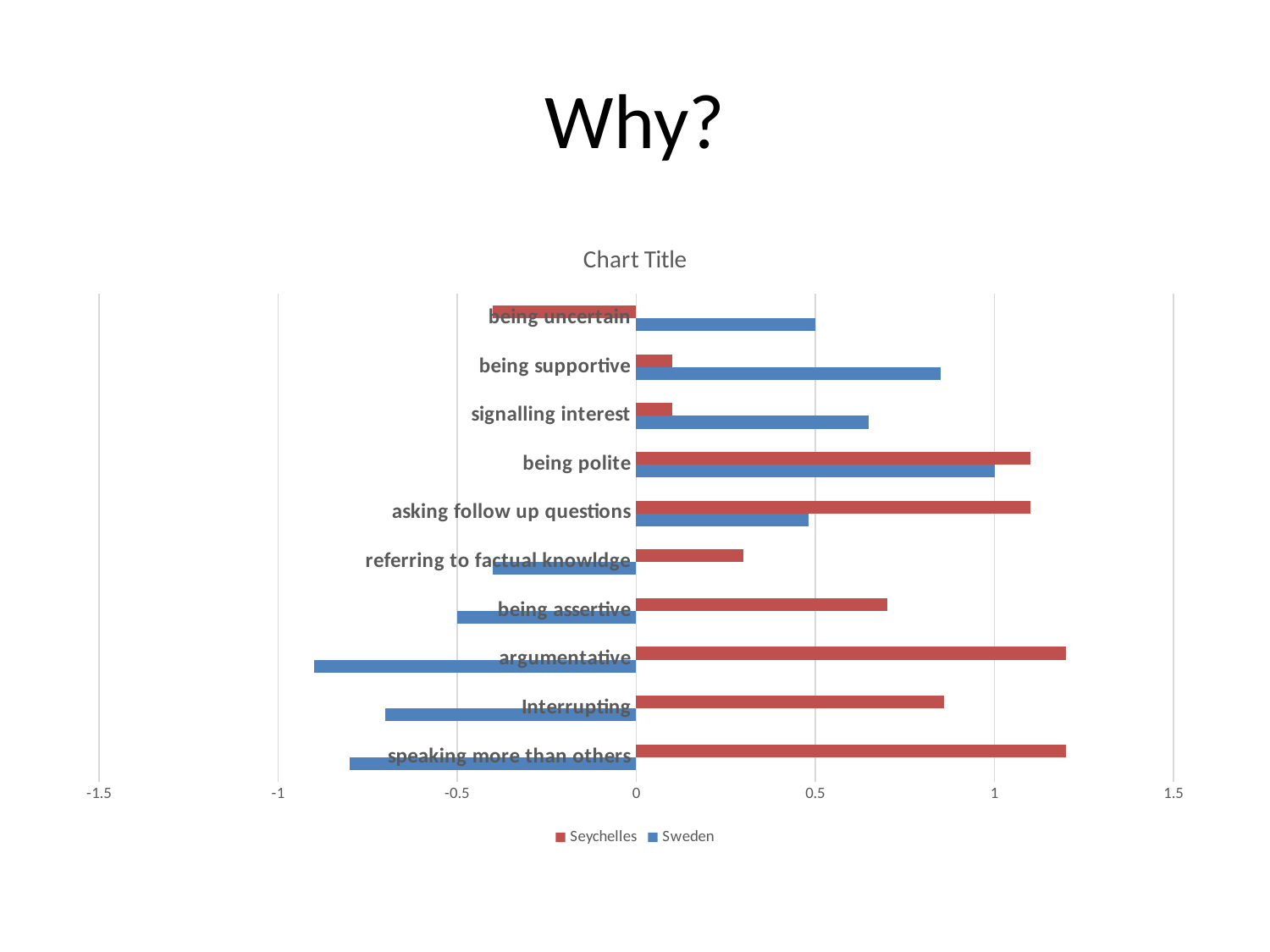
Is the value for Seychelles for argumentative greater or less than 1? greater For being supportive, which series has the larger value, Seychelles or Sweden? Sweden Which category has the highest value for Sweden? being polite Which series is shown in red? Seychelles Which category has the lowest value for Seychelles? being uncertain What kind of chart is shown on the slide? bar chart How many categories are plotted on the chart? 10 Is the value for Sweden for argumentative greater or less than -0.5? less Which category has the lowest value for Sweden? argumentative How many series does the legend list? 2 For asking follow up questions, which series has the larger value, Seychelles or Sweden? Seychelles Is the value for Sweden for being supportive greater or less than 0.5? greater